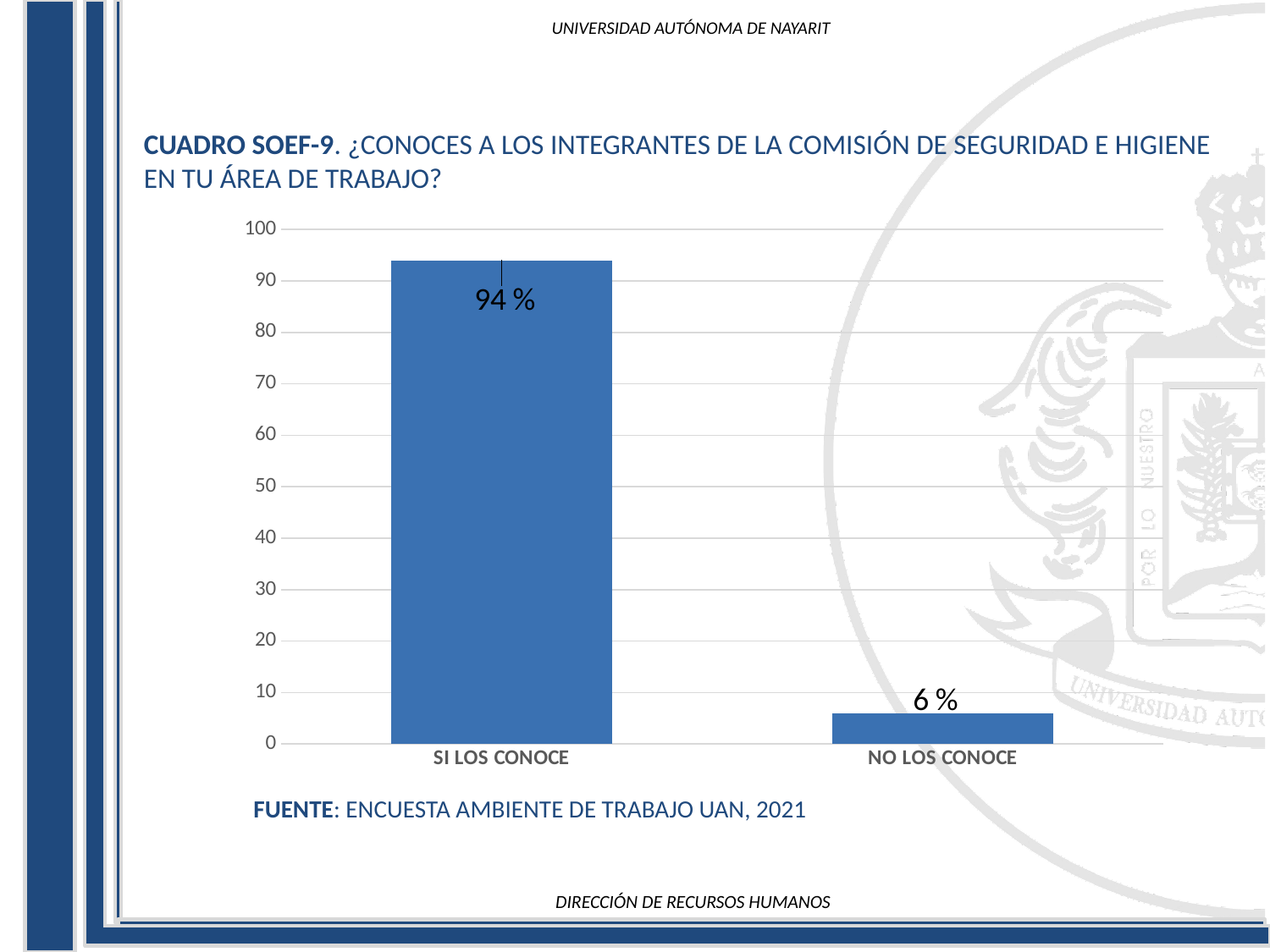
Is the value for SI LOS CONOCE greater or less than 90? greater What is the value for SI LOS CONOCE? 94 % How many categories are shown on the x axis? 2 What is the value for NO LOS CONOCE? 6 % What is the difference between the values for SI LOS CONOCE and NO LOS CONOCE? 88 % What is the highest value shown on the y axis? 100 Which category has the lowest value? NO LOS CONOCE Which category has the highest value? SI LOS CONOCE Is the value for NO LOS CONOCE greater or less than 10? less Which is larger, the value for SI LOS CONOCE or NO LOS CONOCE? SI LOS CONOCE What kind of chart is shown on the slide? bar chart What source is cited below the chart? ENCUESTA AMBIENTE DE TRABAJO UAN, 2021